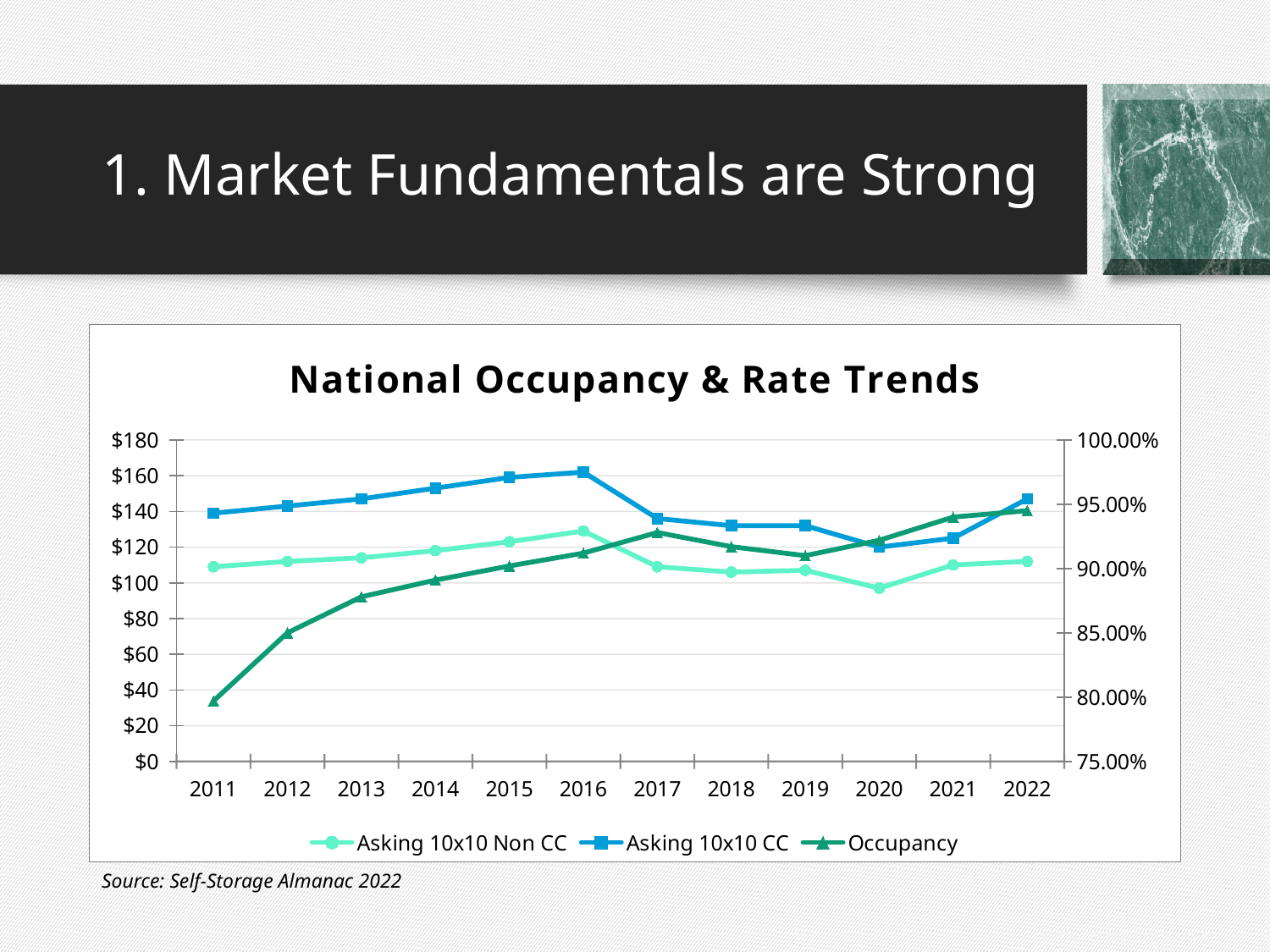
In 2011, which is larger: Asking 10x10 CC or Asking 10x10 Non CC? Asking 10x10 CC Is the Occupancy value for 2012 greater or less than 90.00%? less What type of chart is shown on the slide? Line chart In which year is the Asking 10x10 Non CC series at its lowest? 2020 In which year does the Asking 10x10 CC series reach its highest value? 2016 How many series does the legend list? 3 In which year is Occupancy at its lowest? 2011 How many years are plotted along the x axis? 12 Is the Asking 10x10 CC value for 2016 greater or less than $140? greater Does Occupancy rise or fall from 2011 to 2016? rise Is the Asking 10x10 Non CC value for 2020 greater or less than $100? less In which year does the Asking 10x10 CC series reach its lowest value? 2020